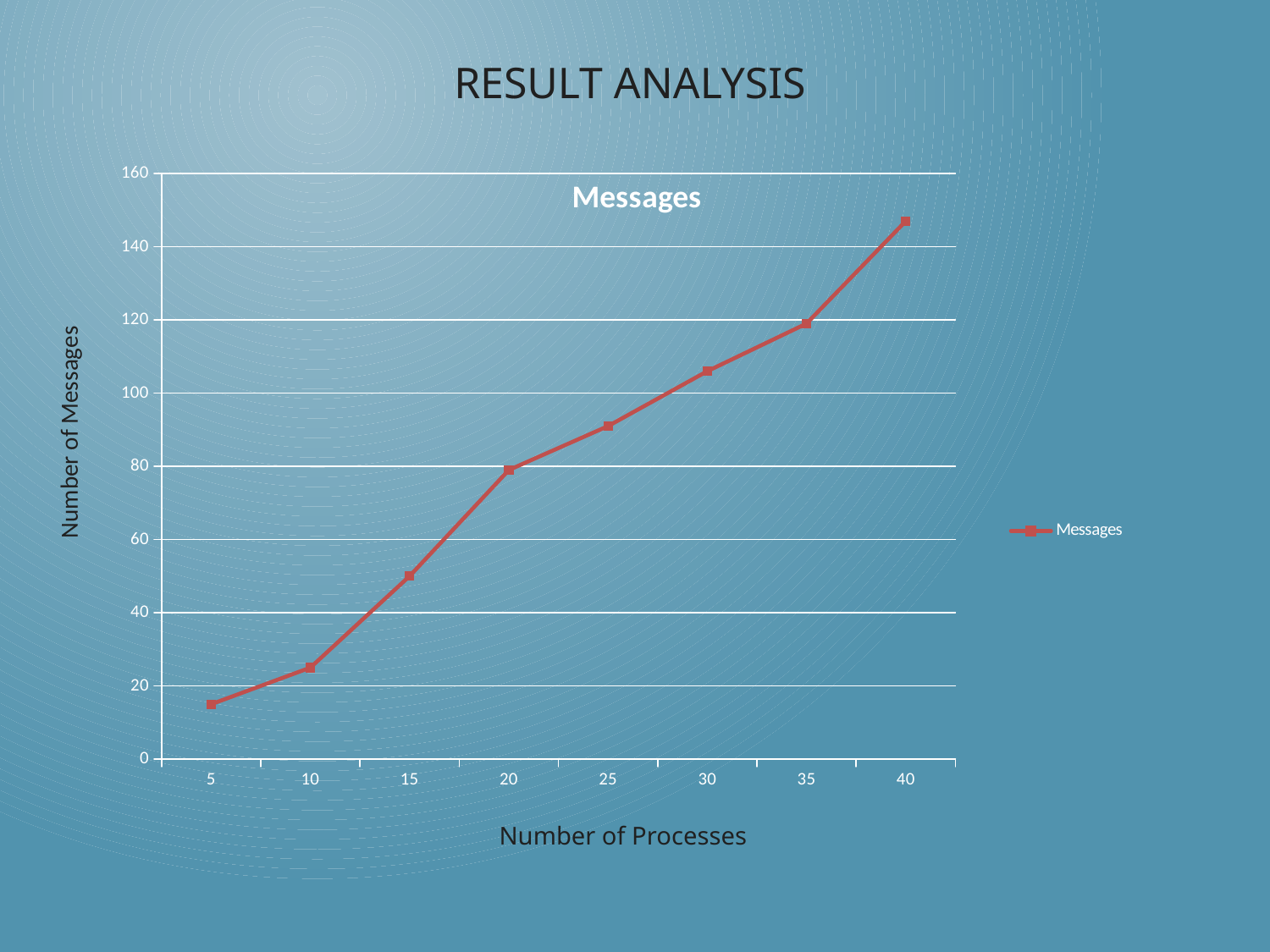
Is the number of messages for 40 processes greater or less than 140? greater Which has more messages, 15 processes or 25 processes? 25 processes What kind of chart is shown on the slide? line chart At which number of processes is the number of messages highest? 40 How many data points are plotted on the line? 8 What is the title of the chart? Messages At which number of processes is the number of messages lowest? 5 Is the number of messages for 30 processes greater or less than 100? greater What is the label of the x axis? Number of Processes Do the values rise or fall as the number of processes increases? rise Is the number of messages for 10 processes greater or less than 40? less How many series does the legend list? 1